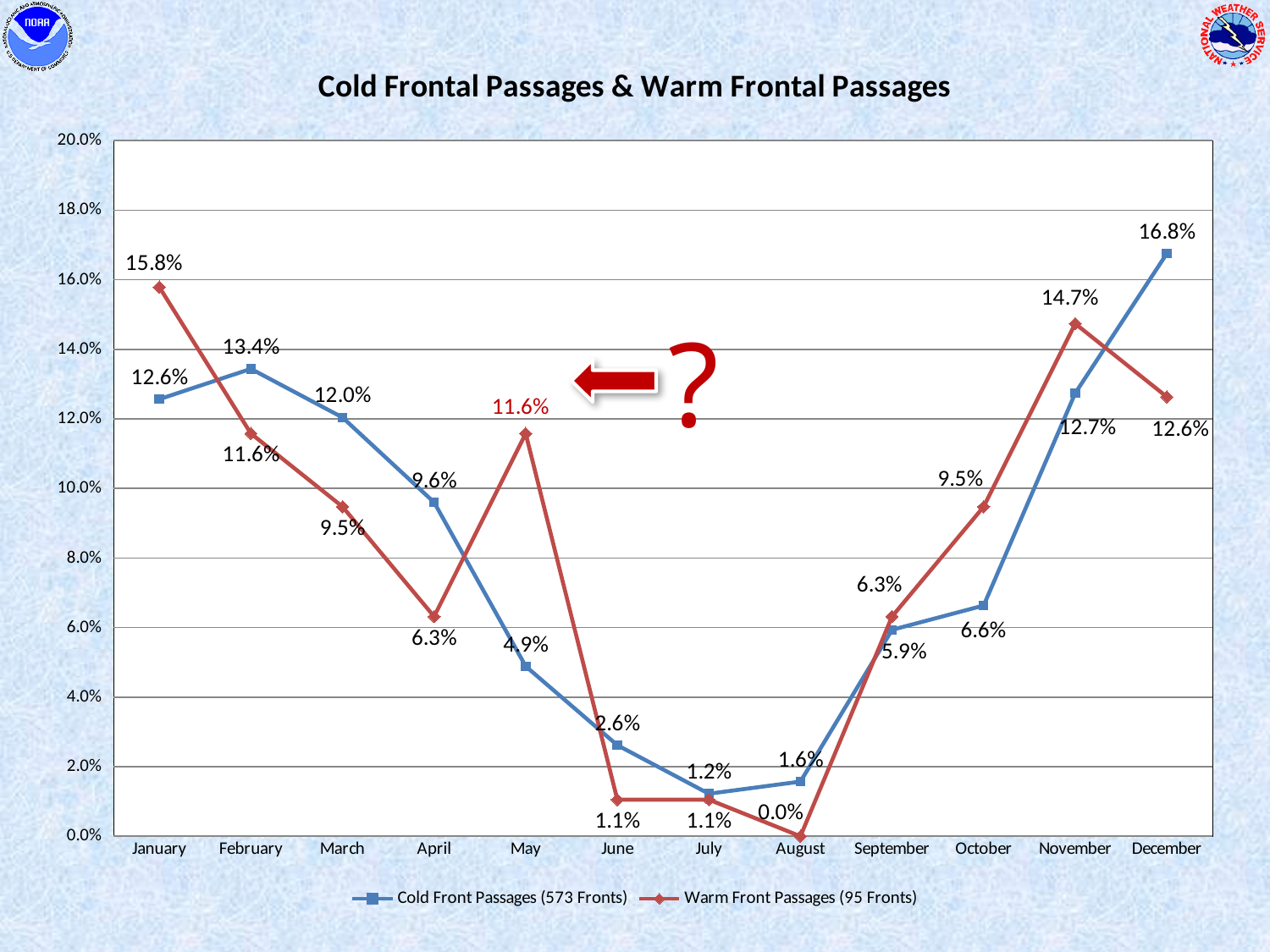
What is the value for Cold Front Passages in December? 16.8% How many months are plotted along the x axis? 12 Which series has the larger value in November, Cold Front Passages or Warm Front Passages? Warm Front Passages What kind of chart is shown on the slide? Line chart In which month is the Warm Front Passages value lowest? August What is the value for Cold Front Passages in May? 4.9% What is the value for Warm Front Passages in May? 11.6% How many series does the legend list? 2 In which month is the Cold Front Passages value highest? December How many fronts does the legend say the Cold Front Passages series is based on? 573 Fronts What is the difference between the Cold Front Passages and Warm Front Passages values in January? 3.2% In which month is the Warm Front Passages value highest? January